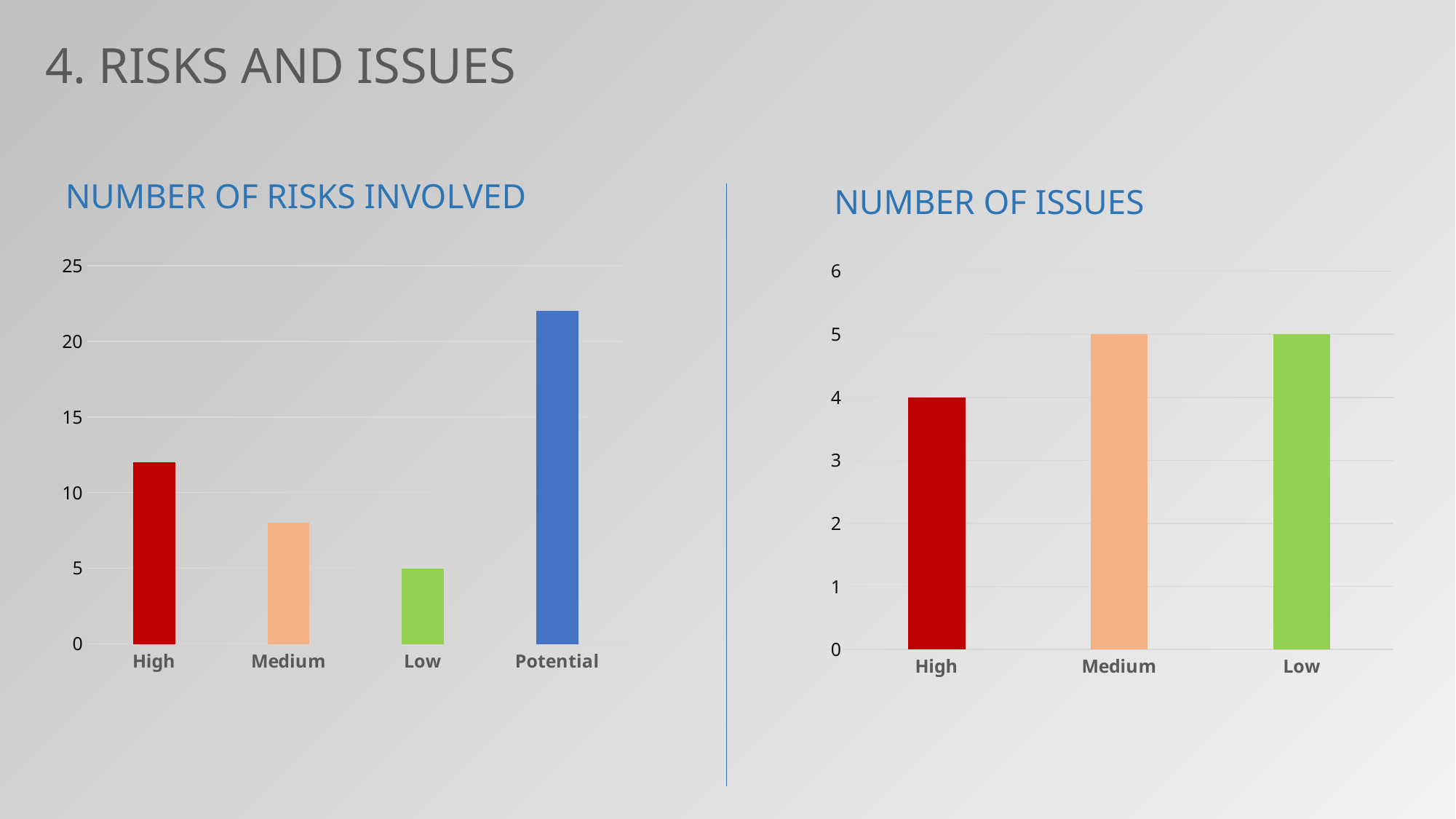
In the "NUMBER OF ISSUES" chart, what is the difference between the values for Medium and High? 1 In the "NUMBER OF RISKS INVOLVED" chart, what is the value for Low? 5 In the "NUMBER OF RISKS INVOLVED" chart, how many categories are shown on the x axis? 4 In the "NUMBER OF RISKS INVOLVED" chart, is the value for Medium greater or less than 10? less In the "NUMBER OF RISKS INVOLVED" chart, is the value for Potential greater or less than 20? greater In the "NUMBER OF RISKS INVOLVED" chart, which is larger, High or Medium? High What kind of chart is the "NUMBER OF RISKS INVOLVED" chart? Bar chart In the "NUMBER OF RISKS INVOLVED" chart, which category has the lowest value? Low In the "NUMBER OF ISSUES" chart, what is the value for High? 4 In the "NUMBER OF ISSUES" chart, which category has the lowest value? High In the "NUMBER OF ISSUES" chart, what is the value for Medium? 5 In the "NUMBER OF RISKS INVOLVED" chart, which category has the highest value? Potential